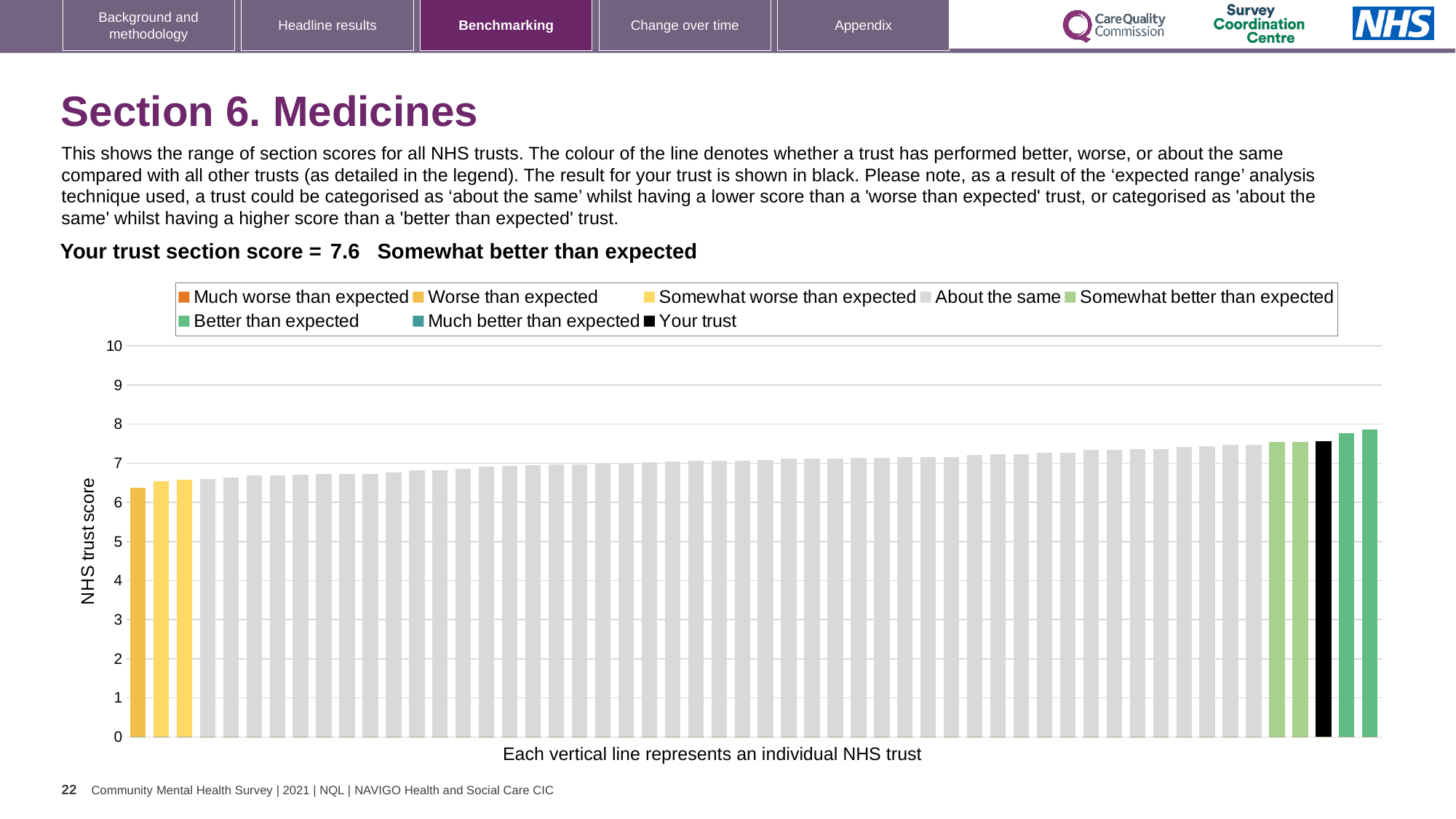
Is the value of the leftmost bar greater or less than 7? less Do the bar values rise or fall from left to right along the x axis? rise What is the section score for your trust shown on the slide? 7.6 Is the value for your trust (the black bar) greater or less than 7? greater What kind of chart is shown on the slide? bar chart What is the label on the vertical axis of the chart? NHS trust score How many entries does the chart legend list? 8 Is your trust's black bar the highest bar on the chart? No What colour is used for the bar representing your trust? black Is the value of the rightmost bar greater or less than 7? greater Which performance category is your trust placed in for Section 6. Medicines? Somewhat better than expected Which is higher, the leftmost bar or the rightmost bar? the rightmost bar